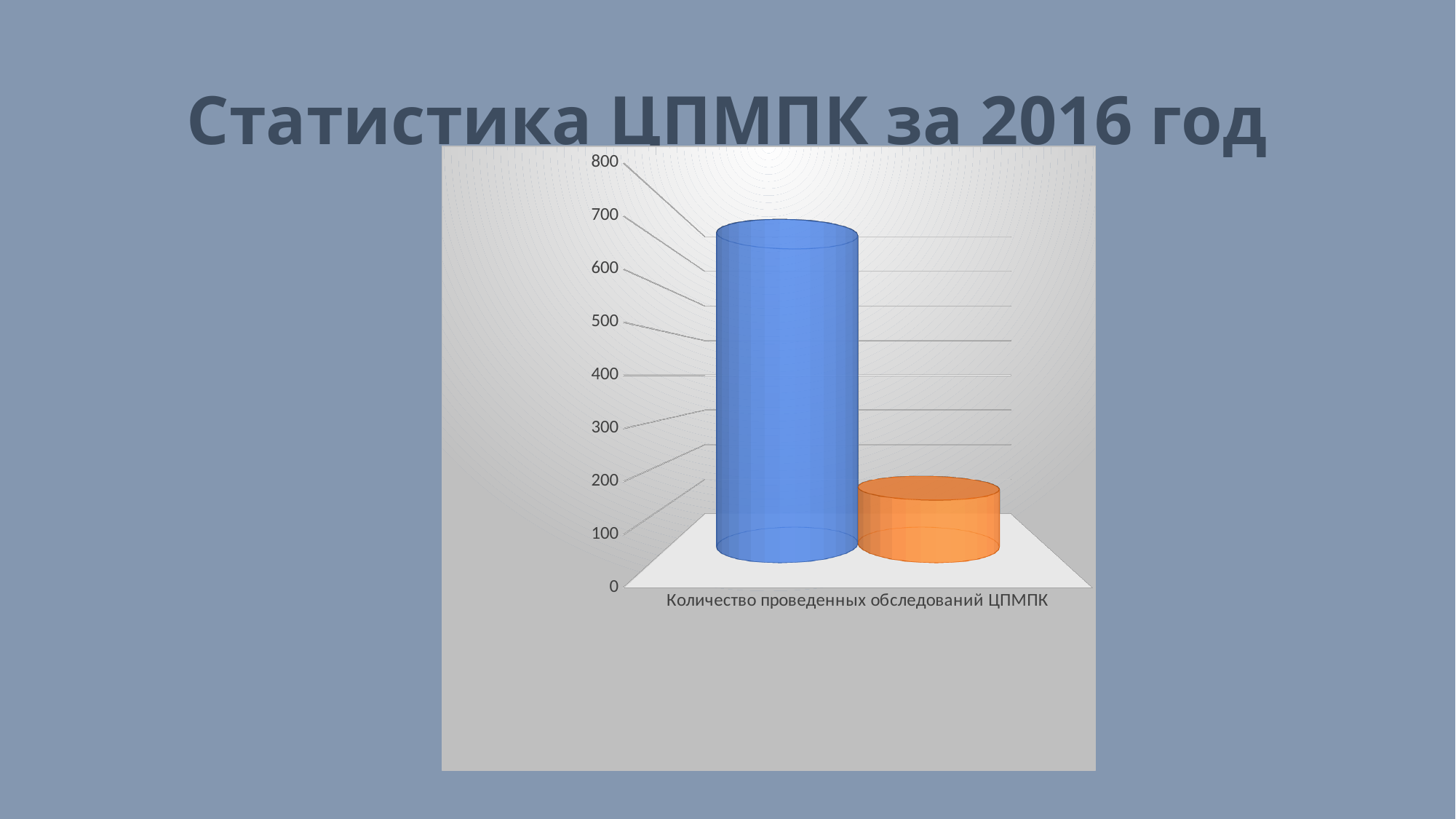
What is the category label on the x axis of the chart? Количество проведенных обследований ЦПМПК Is the value of the orange bar greater or less than 300? less Is the value of the blue bar greater or less than 800? less Is the value of the blue bar greater or less than 500? greater What is the title of the slide containing the chart? Статистика ЦПМПК за 2016 год Which bar is taller, the blue bar or the orange bar? the blue bar How many categories are shown on the x axis of the chart? 1 How many bars are plotted in the chart? 2 What is the highest value shown on the vertical axis of the chart? 800 What kind of chart is shown on the slide? bar chart